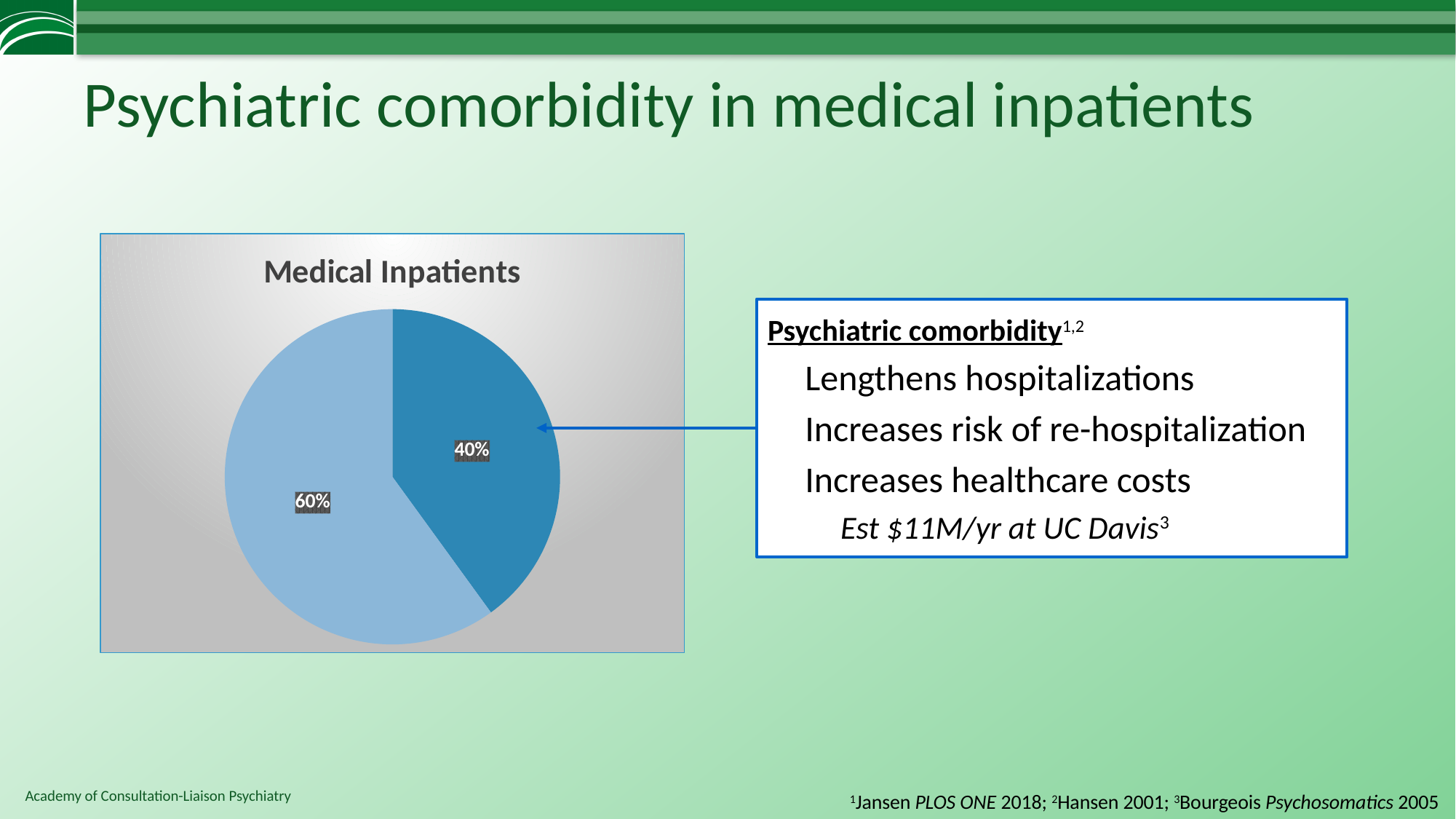
What is the smallest slice value shown in the pie chart? 40% According to the arrow on the slide, what does the 40% slice of the pie represent? Psychiatric comorbidity Is the value of the dark blue slice greater or less than 50%? less What is the title of the chart? Medical Inpatients What kind of chart is shown on the slide? pie chart What share of the pie does the light blue slice represent? 60% What is the largest slice value shown in the pie chart? 60% How many slices does the pie chart have? 2 What share of the pie does the dark blue slice represent? 40% What do the two slice values in the pie chart add up to? 100% Which slice is larger, the dark blue slice or the light blue slice? the light blue slice What is the difference between the two slice values in the pie chart? 20%